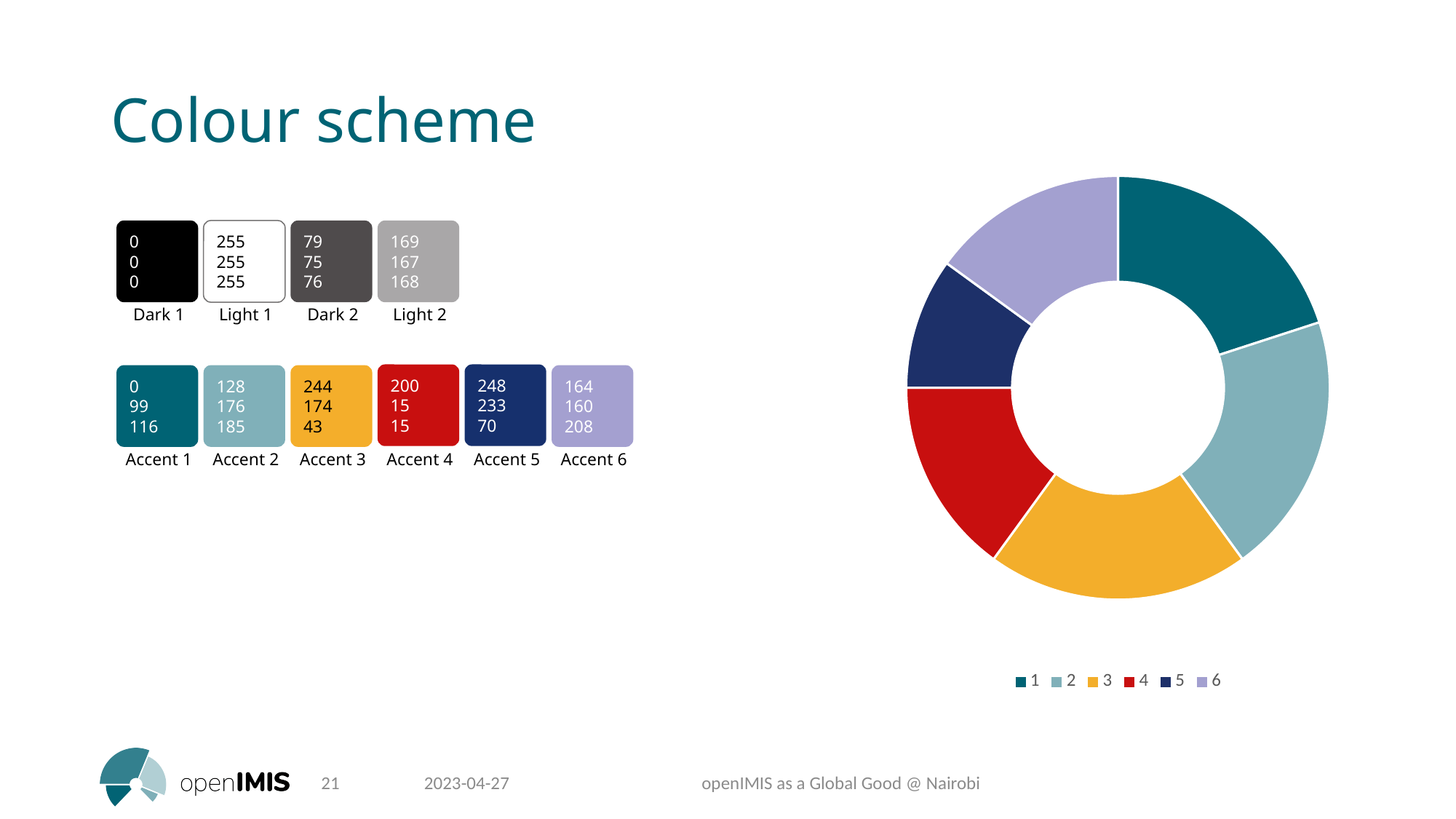
How many entries does the legend of the doughnut chart list? 6 What colour is slice 1 in the doughnut chart? Dark teal In the doughnut chart, which slice is larger, 2 or 5? 2 What kind of chart is shown on the right of the slide? Doughnut (pie) chart In the doughnut chart, which slice is larger, 3 or 5? 3 How many slices does the doughnut chart have? 6 What colour is slice 3 in the doughnut chart? Orange/yellow